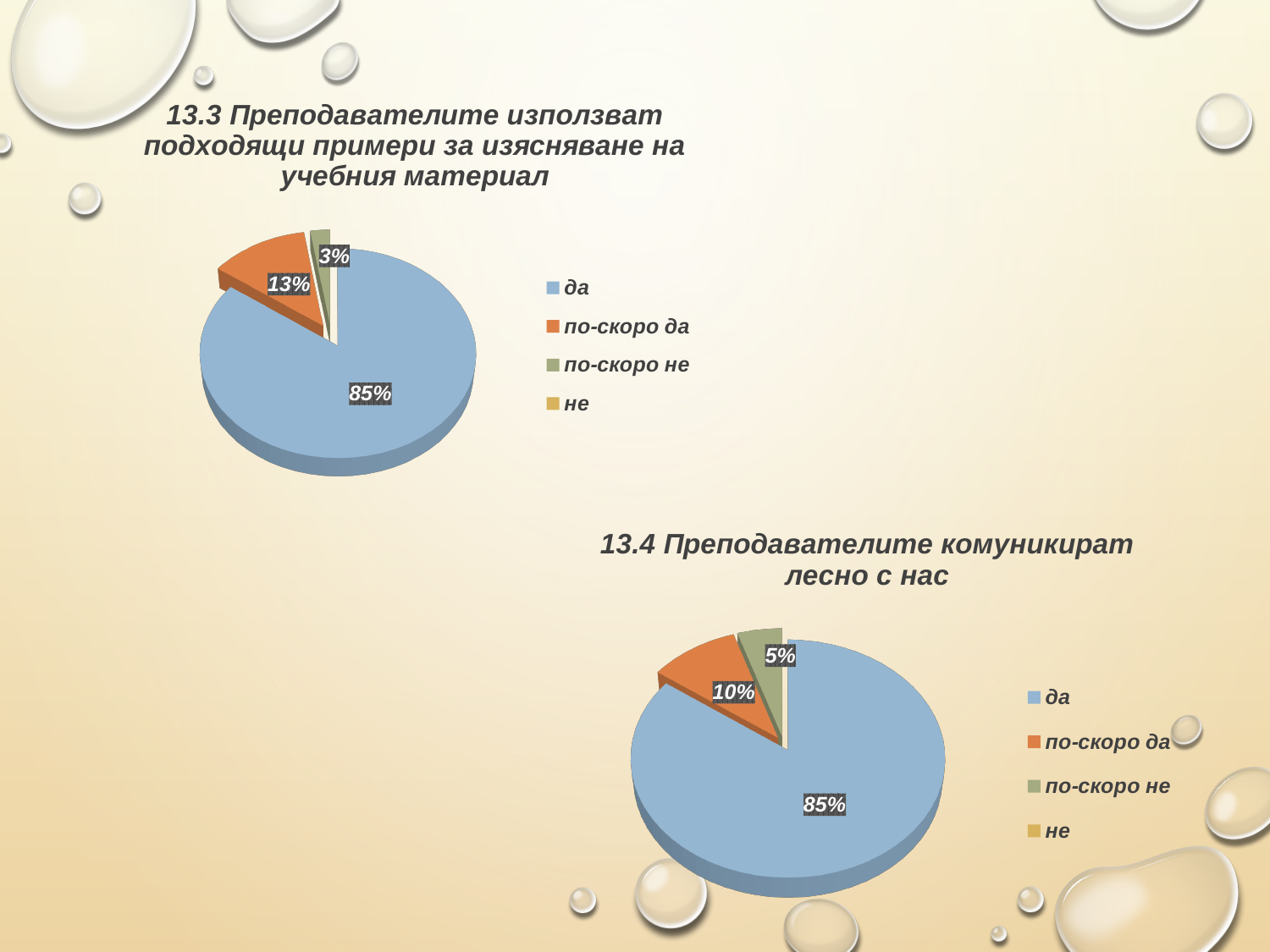
In the chart titled "13.3 Преподавателите използват подходящи примери за изясняване на учебния материал", what share of the pie is "да"? 85% In the chart titled "13.4 Преподавателите комуникират лесно с нас", what is the value for "по-скоро не"? 5% In the chart titled "13.3 Преподавателите използват подходящи примери за изясняване на учебния материал", what colour is the "да" slice? blue In the chart titled "13.4 Преподавателите комуникират лесно с нас", which is larger, "по-скоро да" or "по-скоро не"? по-скоро да How many entries does the legend of the chart titled "13.4 Преподавателите комуникират лесно с нас" list? 4 In the chart titled "13.3 Преподавателите използват подходящи примери за изясняване на учебния материал", what is the value for "по-скоро да"? 13% What kind of chart is the chart titled "13.4 Преподавателите комуникират лесно с нас"? pie chart In the chart titled "13.3 Преподавателите използват подходящи примери за изясняване на учебния материал", which category has the largest slice? да In the chart titled "13.3 Преподавателите използват подходящи примери за изясняване на учебния материал", what is the value for "по-скоро не"? 3% In the chart titled "13.4 Преподавателите комуникират лесно с нас", what is the value for "по-скоро да"? 10% In the chart titled "13.3 Преподавателите използват подходящи примери за изясняване на учебния материал", what is the difference between "по-скоро да" and "по-скоро не"? 10% In the chart titled "13.4 Преподавателите комуникират лесно с нас", what share of the pie is "да"? 85%